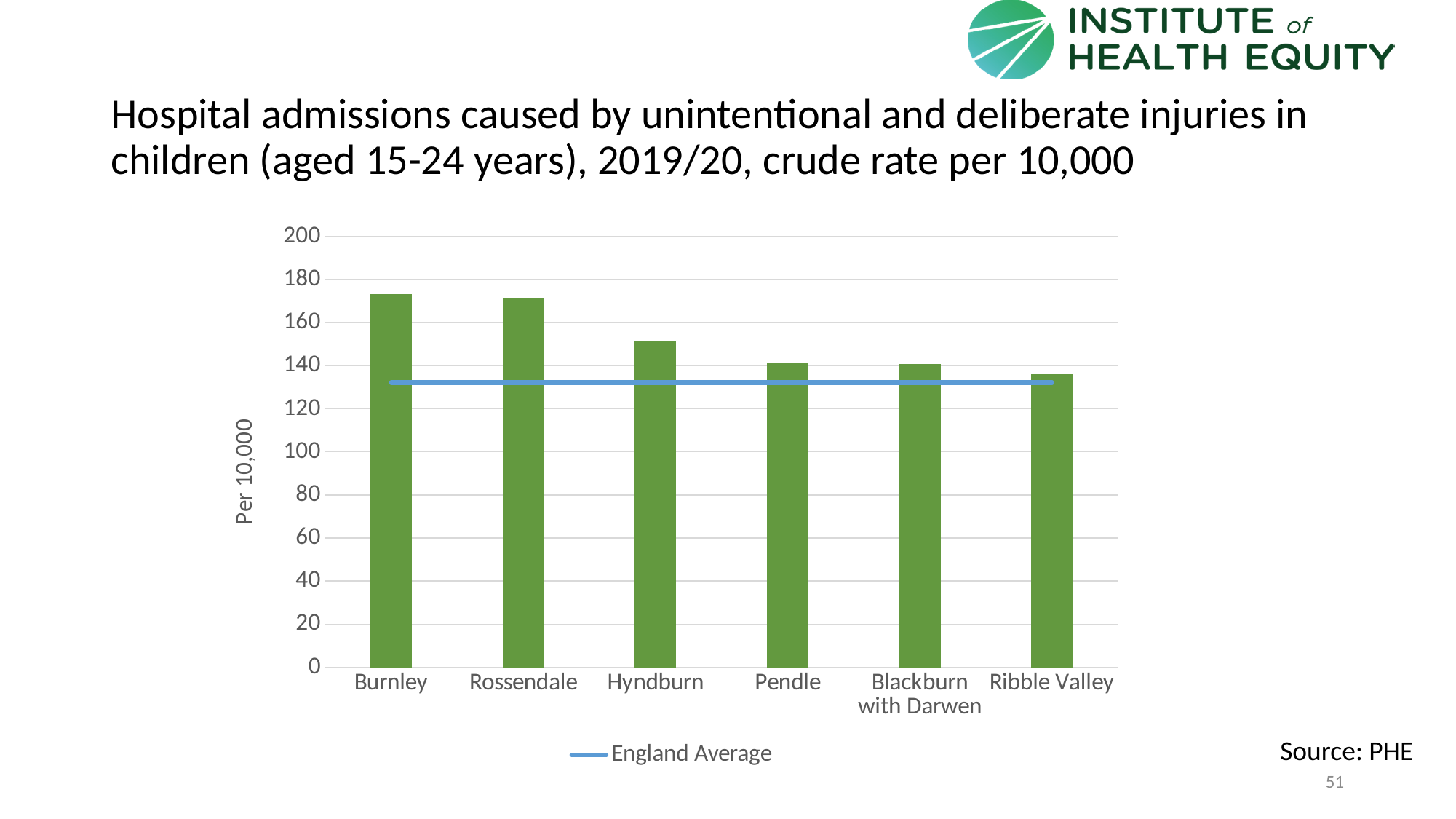
Is the value for Burnley greater or less than 160? greater Do the bar values rise or fall from left to right across the x axis? Fall Is the value for Hyndburn greater or less than 160? less Is the value for Ribble Valley greater or less than 140? less How many entries does the chart's legend list? 1 What is the label on the chart's vertical axis? Per 10,000 What kind of chart is shown on the slide? Combination bar and line chart (bars for each area with a line for the England average) Which has the higher value, Burnley or Hyndburn? Burnley Which has the higher value, Hyndburn or Pendle? Hyndburn Which area has the lowest hospital admission rate in the chart? Ribble Valley How many local areas are shown on the x axis of the chart? 6